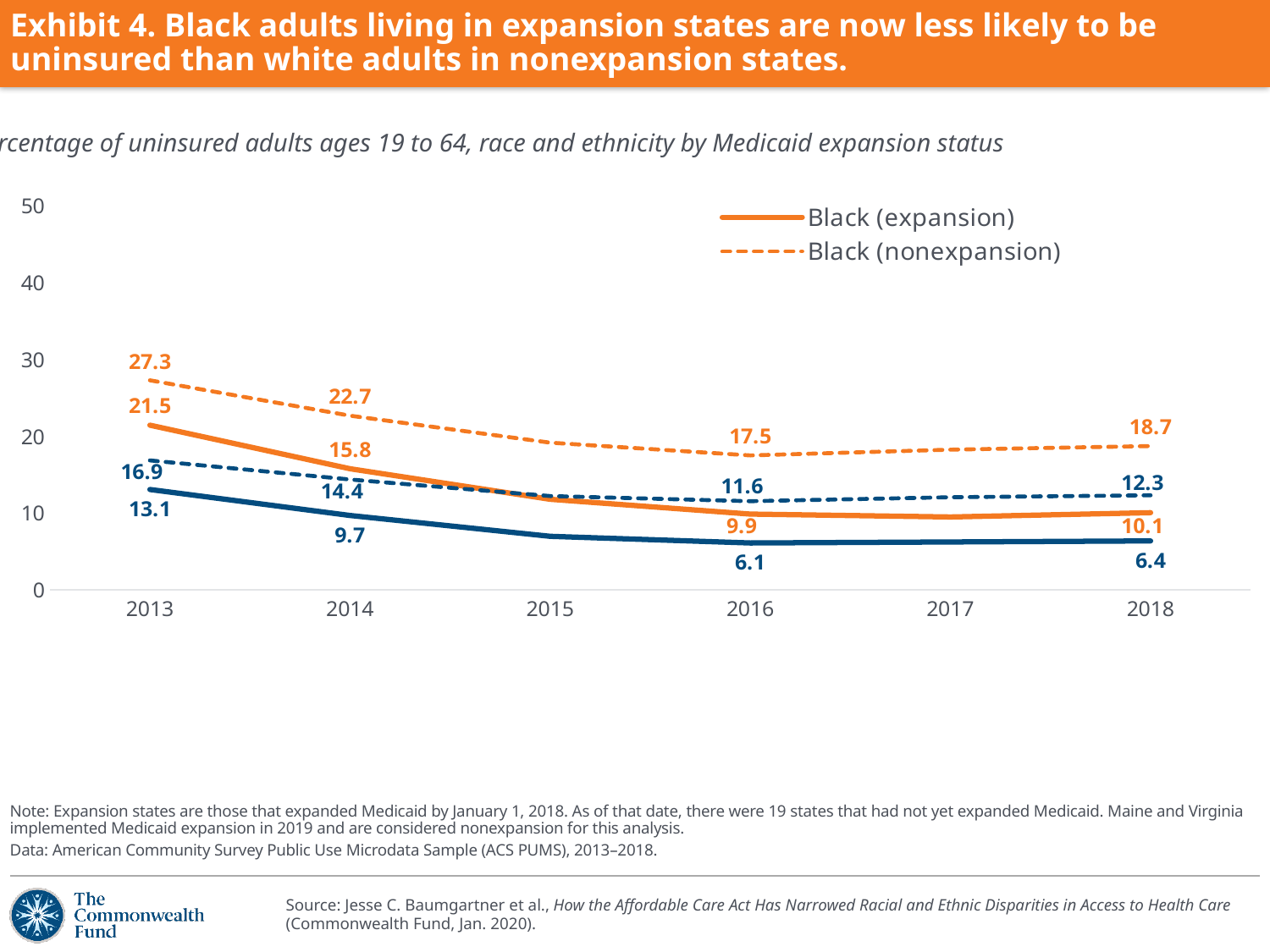
In 2016, which was larger: Black (expansion) or Black (nonexpansion)? Black (nonexpansion) What type of chart is shown on the slide? line chart How many series does the legend list? 2 What was the percentage of uninsured Black adults in nonexpansion states in 2018? 18.7 What was the percentage of uninsured Black adults in expansion states in 2013? 21.5 In 2013, how much higher was the Black (nonexpansion) value than the Black (expansion) value? 5.8 Did the Black (expansion) value rise or fall from 2013 to 2016? fall By how much did the Black (expansion) value fall from 2013 to 2018? 11.4 What value is shown for Black (nonexpansion) in 2014? 22.7 In which year was the Black (nonexpansion) value highest? 2013 What value is shown for Black (expansion) in 2016? 9.9 How many years are shown on the x axis? 6